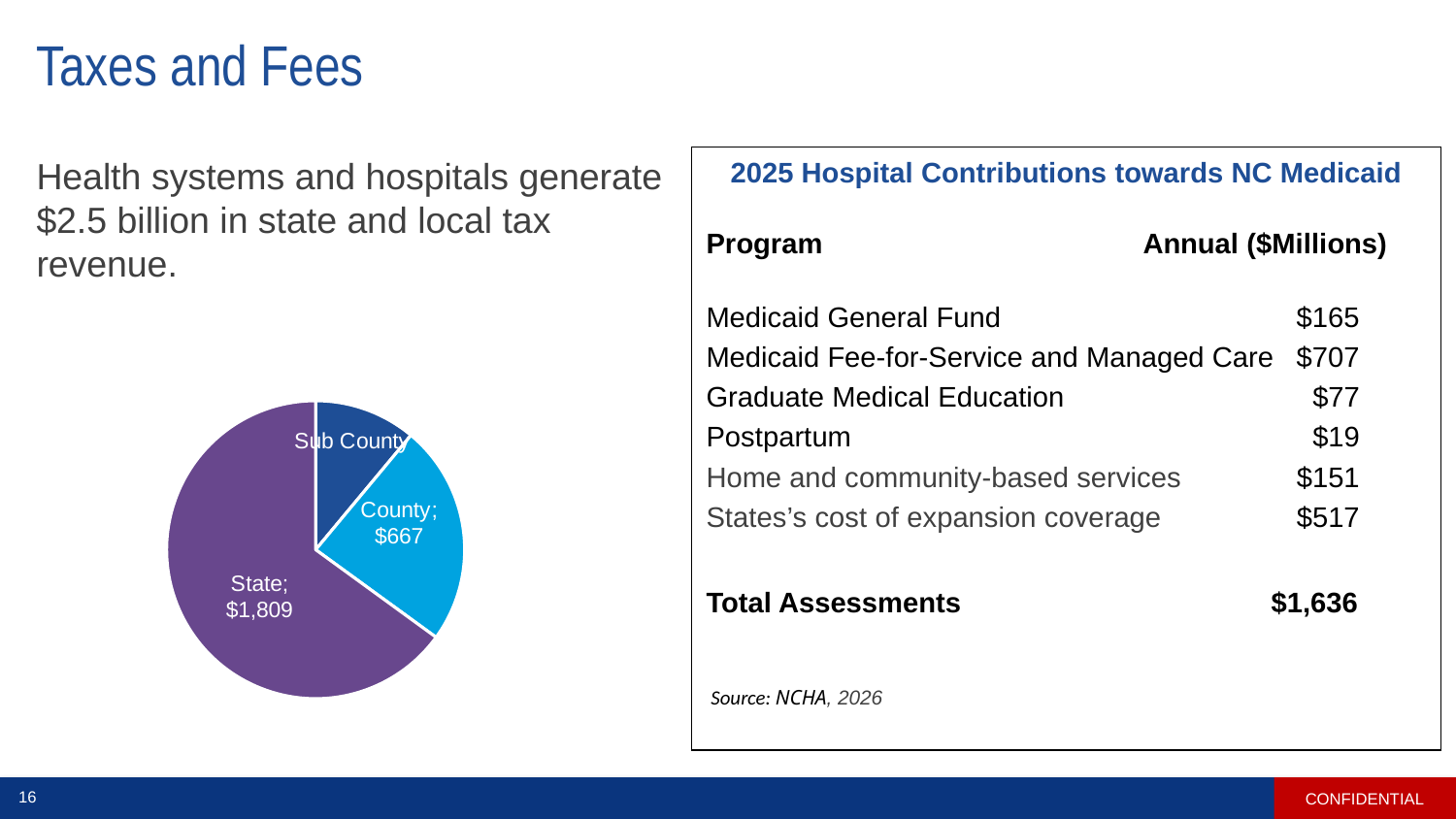
How many slices does the pie chart have? 3 Which slice of the pie chart is the largest? State What kind of chart is shown on the left of the slide? pie chart In the pie chart, which is larger, County or Sub County? County What is the value shown for the State slice in the pie chart? $1,809 Which slice of the pie chart is the smallest? Sub County Which slice of the pie chart is coloured purple? State What is the difference between the State value and the County value in the pie chart? $1,142 What colour is the County slice in the pie chart? light blue In the pie chart, which is larger, State or County? State What is the value shown for the County slice in the pie chart? $667